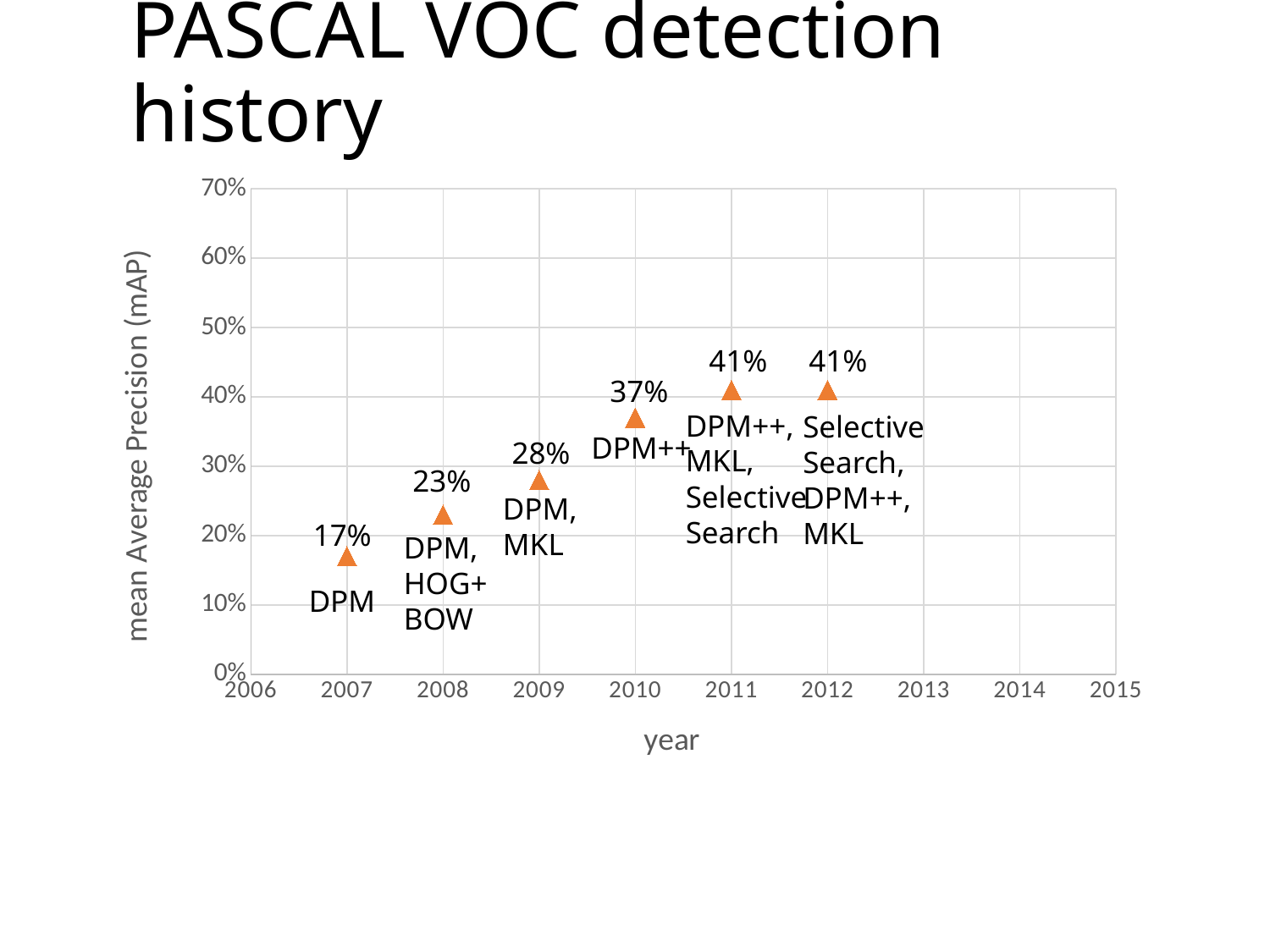
What is the difference between the mAP values for 2010 and 2008? 14% What kind of chart is shown on the slide? scatter chart Do the mAP values generally rise or fall from 2007 to 2012? rise What is the difference between the mAP values for 2011 and 2007? 24% How many data points are plotted on the chart? 6 Is the mAP value for 2010 greater or less than 30%? greater What is the highest mAP value shown on the chart? 41% Which year has a larger mAP value, 2008 or 2009? 2009 What is the mAP value plotted for 2009? 28% What is the mAP value plotted for 2010? 37% Which year has the lowest mAP value? 2007 What is the mean Average Precision (mAP) value for 2007? 17%